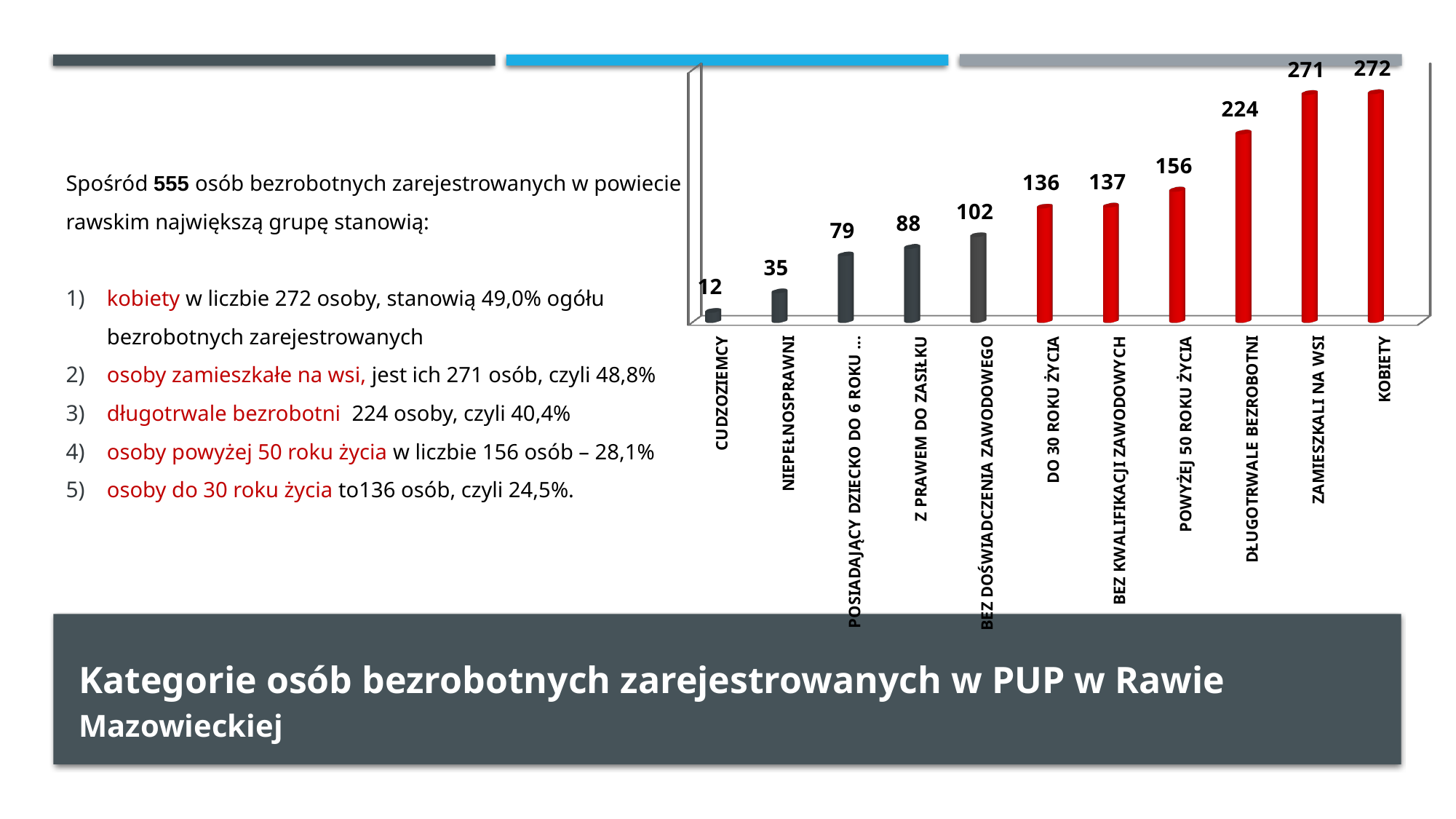
Which category has the highest value? KOBIETY Which category has the lowest value? CUDZOZIEMCY What is the value for BEZ DOŚWIADCZENIA ZAWODOWEGO? 102 What kind of chart is shown on the slide? bar chart Which is larger, the value for Z PRAWEM DO ZASIŁKU or the value for BEZ DOŚWIADCZENIA ZAWODOWEGO? BEZ DOŚWIADCZENIA ZAWODOWEGO Do the values rise or fall from left to right along the x axis? rise What is the difference between the values for ZAMIESZKALI NA WSI and DŁUGOTRWALE BEZROBOTNI? 47 What is the value for KOBIETY? 272 What is the difference between the values for POWYŻEJ 50 ROKU ŻYCIA and DO 30 ROKU ŻYCIA? 20 What is the value for NIEPEŁNOSPRAWNI? 35 What is the value for DŁUGOTRWALE BEZROBOTNI? 224 How many categories are shown in the chart? 11